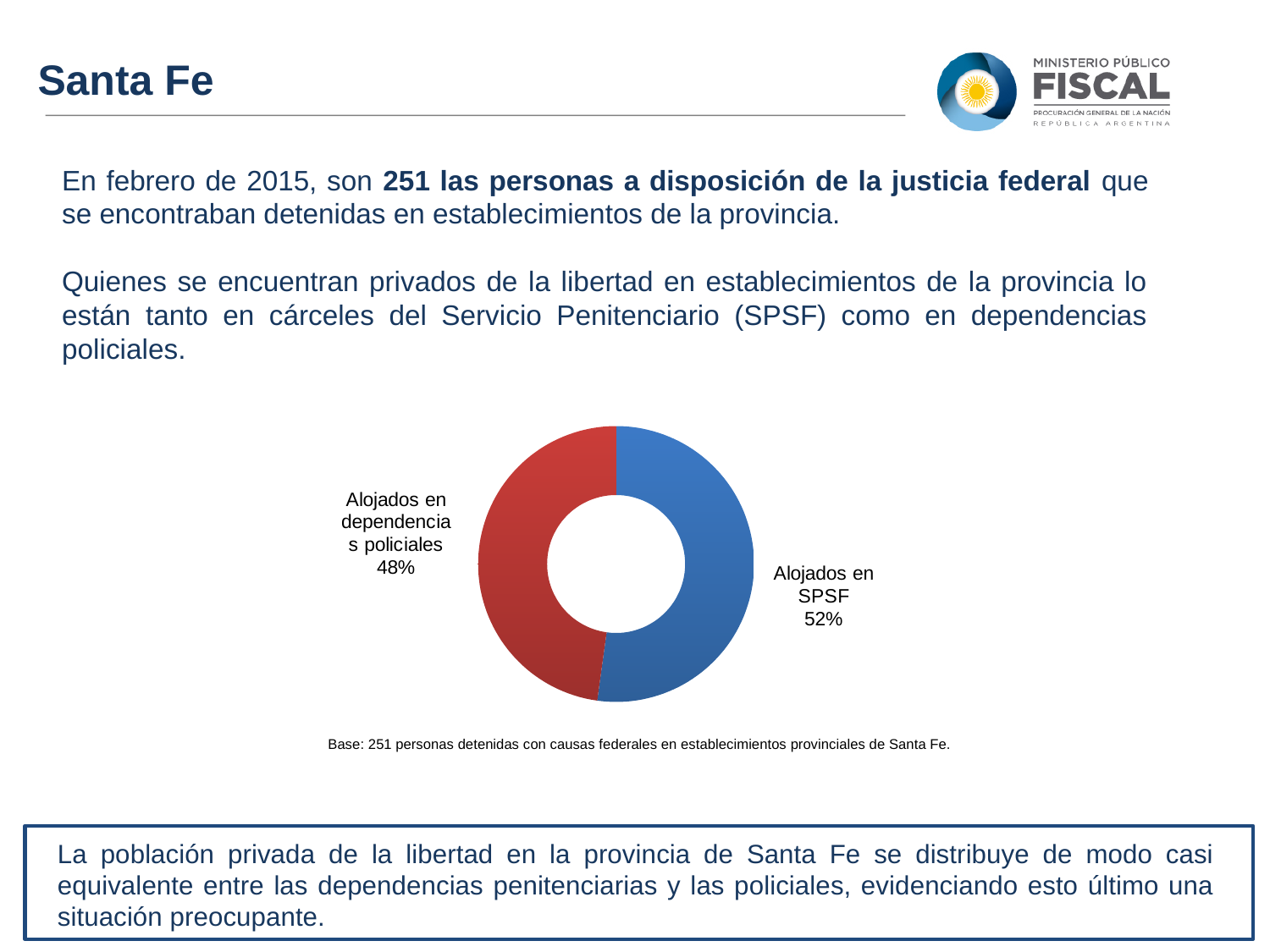
What share of the chart is labelled "Alojados en dependencias policiales"? 48% What is the total of the two shares shown in the chart? 100% What kind of chart is shown on the slide? Doughnut chart What colour is the slice for "Alojados en dependencias policiales"? Red What colour is the slice for "Alojados en SPSF"? Blue Which category has the largest share in the chart? Alojados en SPSF Which is larger: the share for "Alojados en SPSF" or the share for "Alojados en dependencias policiales"? Alojados en SPSF How many categories does the chart show? 2 Which category has the smallest share in the chart? Alojados en dependencias policiales What share of the chart is labelled "Alojados en SPSF"? 52% What is the difference in percentage points between the share for "Alojados en SPSF" and the share for "Alojados en dependencias policiales"? 4